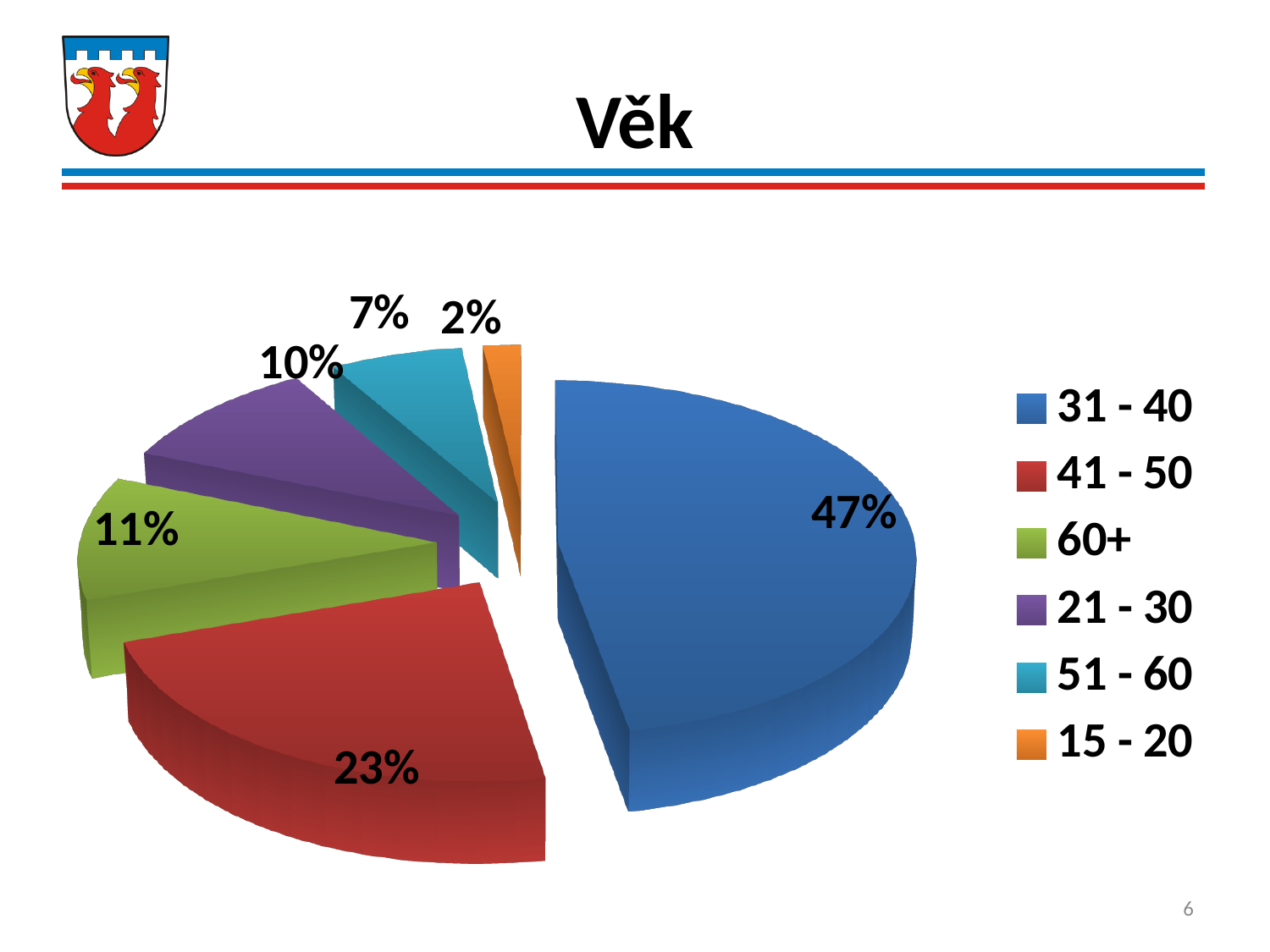
What percentage is shown for the 41 - 50 age group? 23% What is the title of the chart? Věk Which age group has a larger share, 51 - 60 or 21 - 30? 21 - 30 What percentage is shown for the 15 - 20 age group? 2% Which age group has the smallest share of the pie? 15 - 20 What type of chart is shown on the slide? Pie chart What percentage is shown for the 21 - 30 age group? 10% What is the difference in percentage points between the 31 - 40 and 41 - 50 age groups? 24 What percentage is shown for the 31 - 40 age group? 47% Which age group has the largest share of the pie? 31 - 40 How many age groups are shown in the pie chart? 6 What percentage is shown for the 60+ age group? 11%